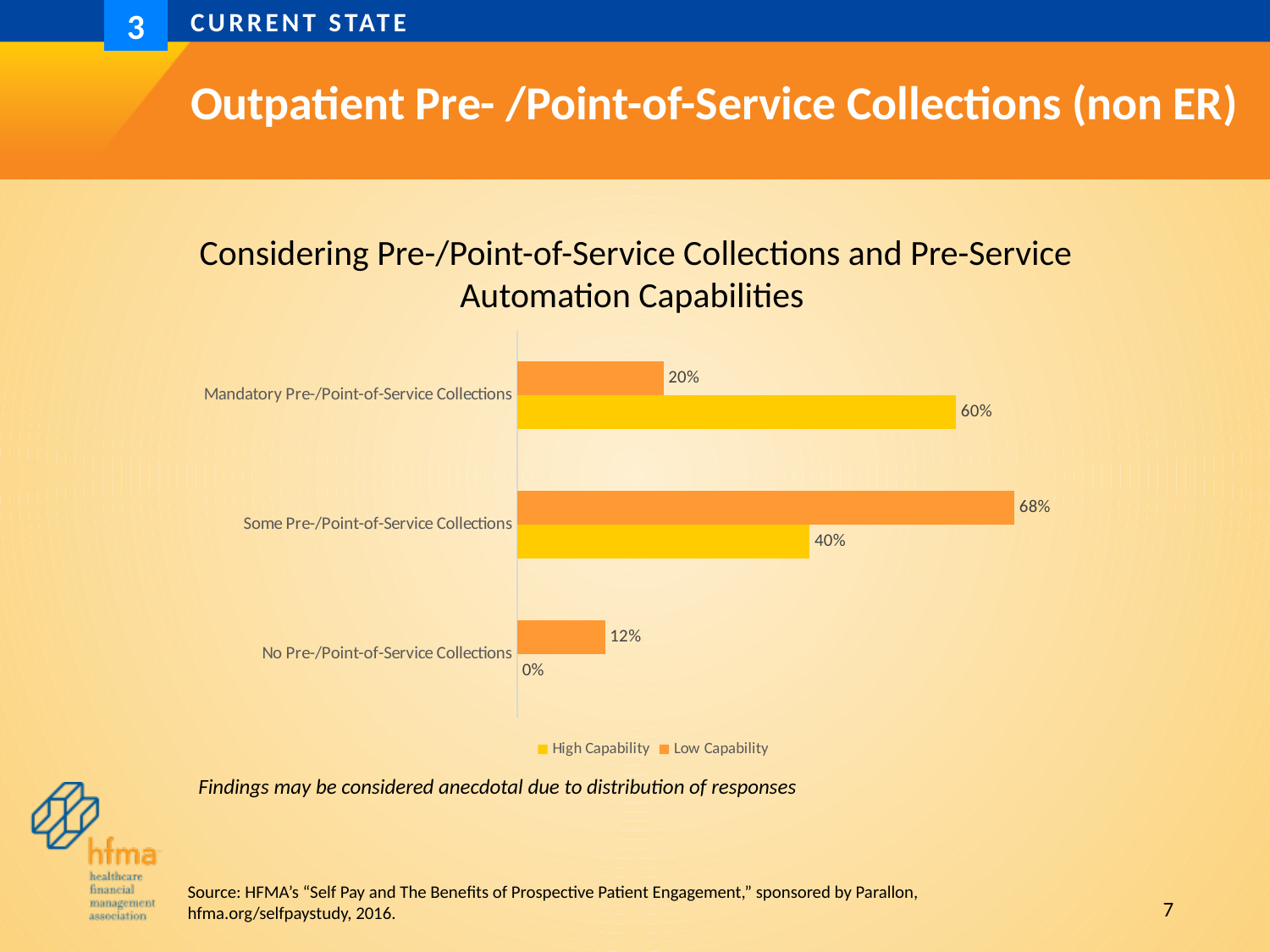
Which category has the highest Low Capability value? Some Pre-/Point-of-Service Collections For Some Pre-/Point-of-Service Collections, which is larger: the High Capability value or the Low Capability value? Low Capability What is the Low Capability value for Mandatory Pre-/Point-of-Service Collections? 20% What is the Low Capability value for Some Pre-/Point-of-Service Collections? 68% Which series is shown in orange? Low Capability What is the High Capability value for No Pre-/Point-of-Service Collections? 0% How many series does the legend list? 2 How many categories are shown on the chart? 3 Which category has the lowest High Capability value? No Pre-/Point-of-Service Collections What is the High Capability value for Mandatory Pre-/Point-of-Service Collections? 60% What is the difference between the High Capability and Low Capability values for Mandatory Pre-/Point-of-Service Collections? 40% What kind of chart is shown on the slide? Bar chart